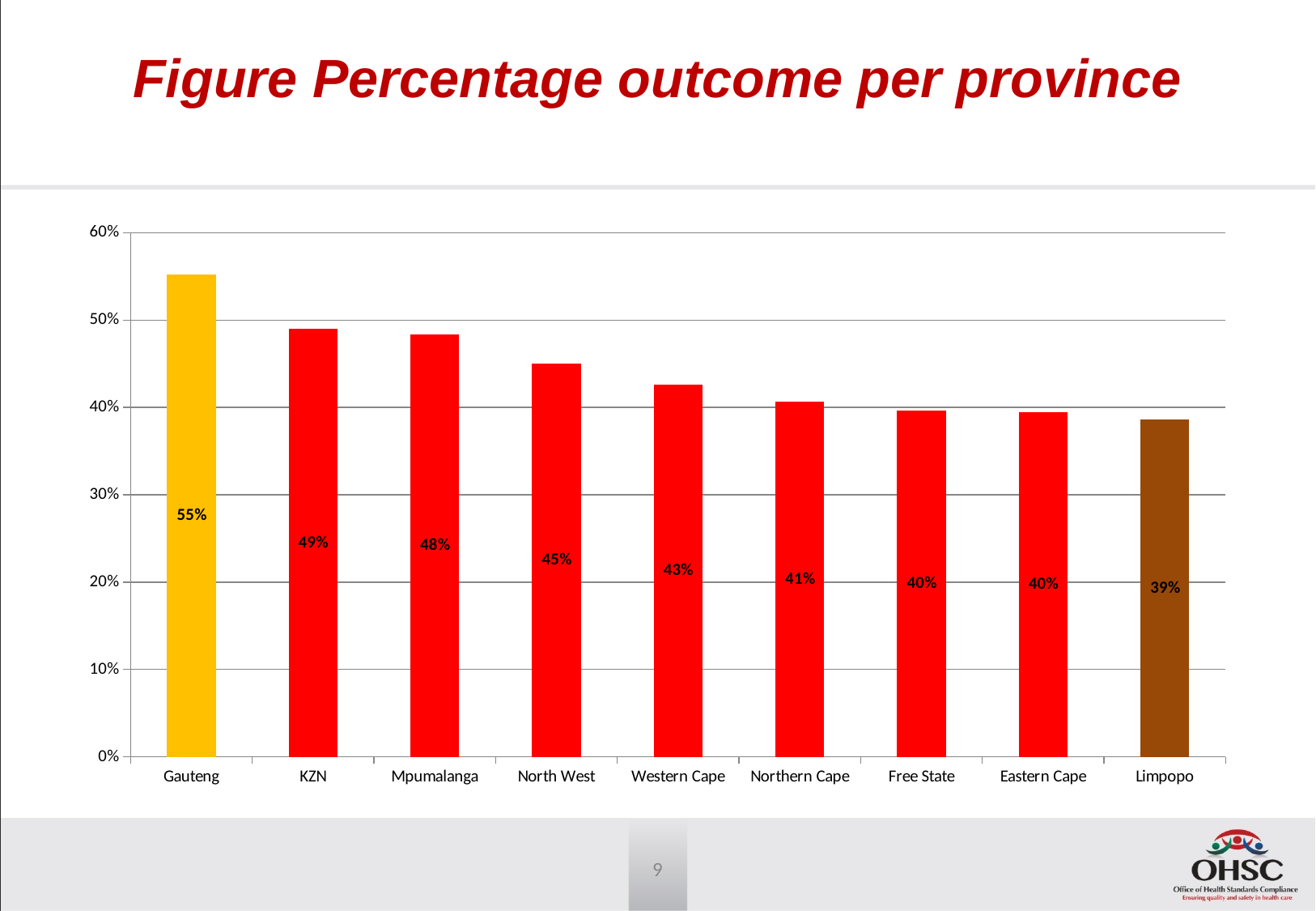
What colour is the bar for Gauteng? Yellow What is the percentage outcome for Limpopo? 39% Do the values rise or fall from left to right across the provinces? Fall Which province has the highest percentage outcome? Gauteng What is the percentage outcome for Gauteng? 55% What kind of chart is shown on the slide? Bar chart Which province has the lowest percentage outcome? Limpopo Is the value for Mpumalanga greater or less than 50%? less What is the difference between the percentage outcomes of Gauteng and KZN? 6% How many provinces are shown in the chart? 9 Which has a higher percentage outcome, North West or Northern Cape? North West What is the percentage outcome for Western Cape? 43%